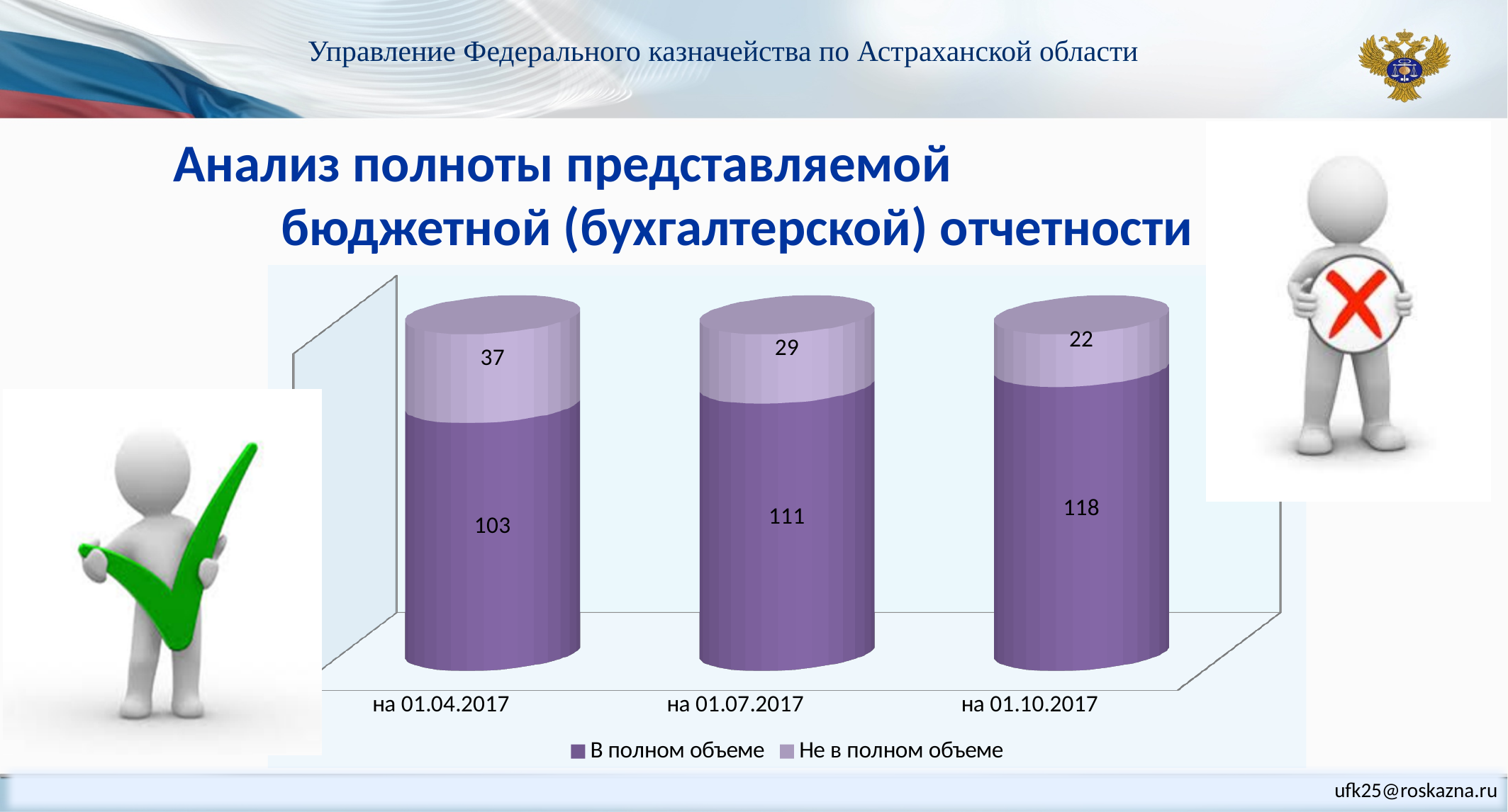
How many dates are shown on the x axis? 3 Which is larger: "Не в полном объеме" on 01.04.2017 or on 01.07.2017? на 01.04.2017 How many series does the legend list? 2 What is the value for "Не в полном объеме" on 01.10.2017? 22 What is the total of the stacked bar for 01.07.2017? 140 On which date is the value for "Не в полном объеме" lowest? на 01.10.2017 What kind of chart is shown? stacked bar chart What is the value for "В полном объеме" on 01.04.2017? 103 What is the value for "Не в полном объеме" on 01.07.2017? 29 Does the value for "Не в полном объеме" rise or fall across the dates? fall What is the difference between the "В полном объеме" values on 01.10.2017 and 01.04.2017? 15 On which date is the value for "В полном объеме" highest? на 01.10.2017